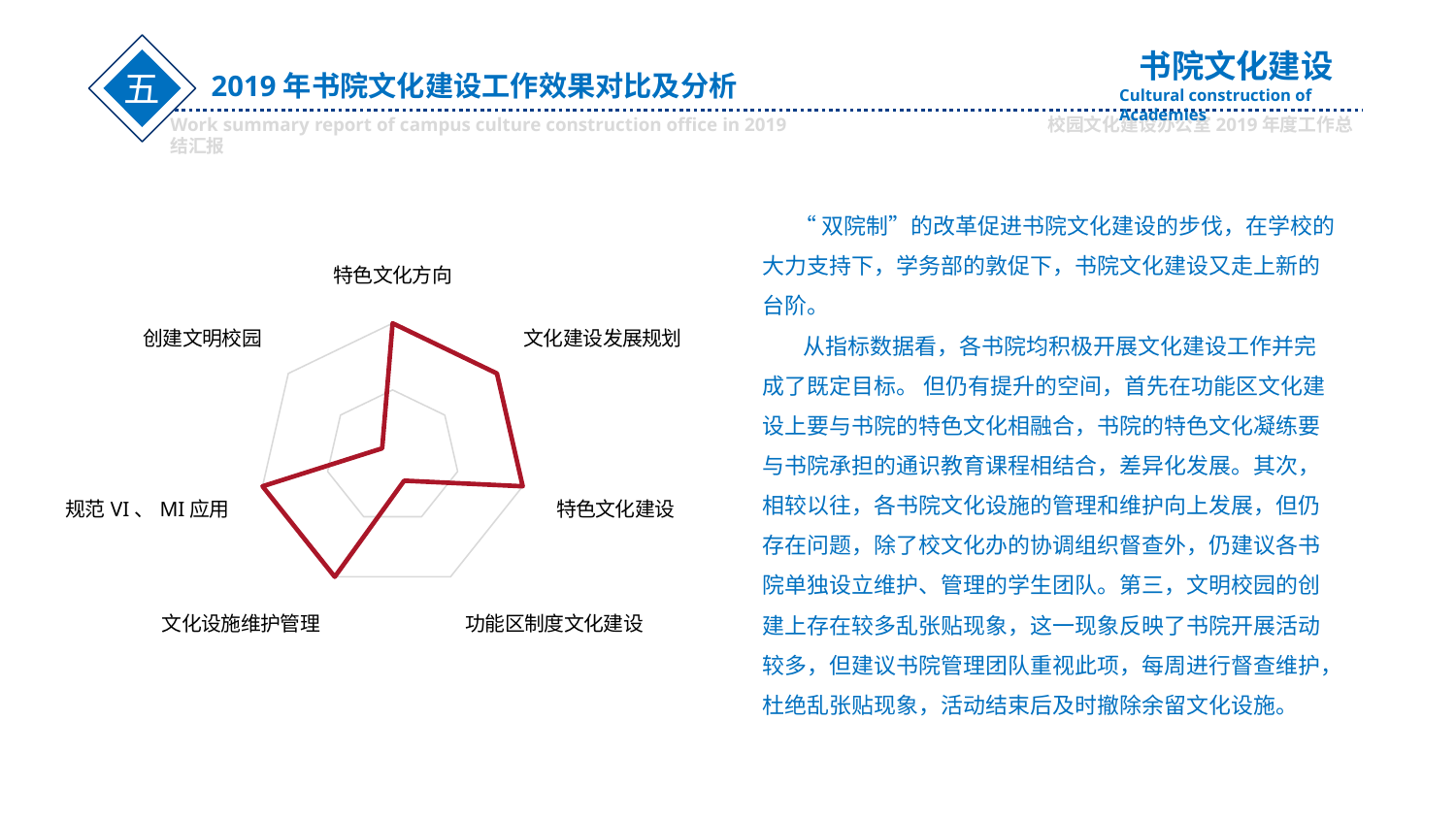
Which is larger on the radar chart, the value for 规范 VI、MI 应用 or the value for 功能区制度文化建设? 规范 VI、MI 应用 Which is larger on the radar chart, the value for 特色文化建设 or the value for 功能区制度文化建设? 特色文化建设 What kind of chart is shown on the slide? Radar chart Which is larger on the radar chart, the value for 文化设施维护管理 or the value for 创建文明校园? 文化设施维护管理 What category label appears at the top of the radar chart? 特色文化方向 How many categories (axes) does the radar chart have? 7 What colour is the data line on the radar chart? Red How many data series are plotted on the radar chart? 1